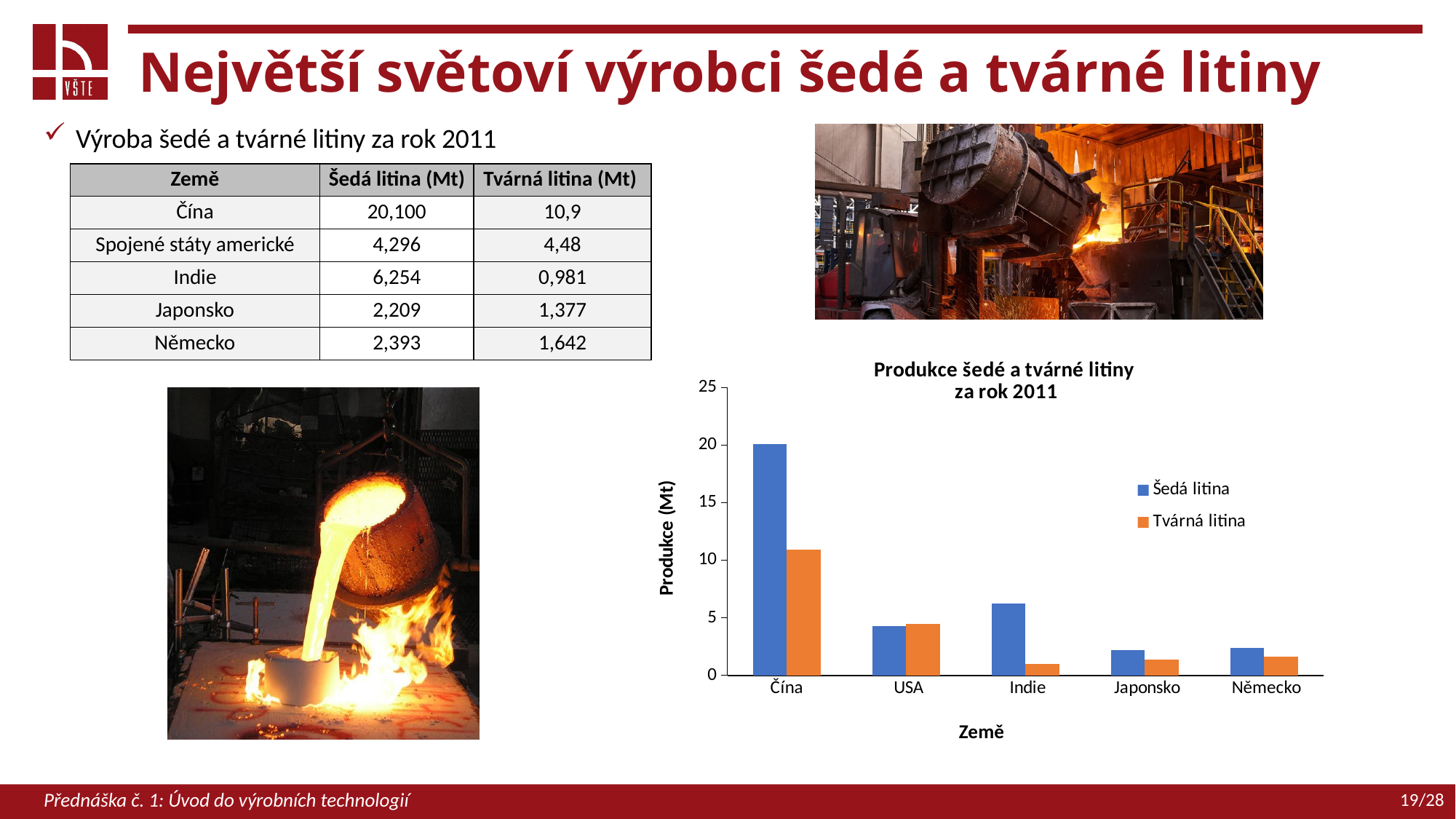
How many series does the chart legend list? 2 Which country has the highest Šedá litina value in the chart? Čína Is the Šedá litina value for Čína greater or less than 15? greater What is the label of the chart's y axis? Produkce (Mt) What kind of chart is shown on the slide? bar chart What is the title of the chart? Produkce šedé a tvárné litiny za rok 2011 Which country has the highest Tvárná litina value in the chart? Čína For Indie, which is larger: Šedá litina or Tvárná litina? Šedá litina Which country has the lowest Tvárná litina value in the chart? Indie Is the Šedá litina value for Indie greater or less than 5? greater How many countries are shown on the x axis of the chart? 5 Is the Šedá litina value for Japonsko greater or less than 5? less